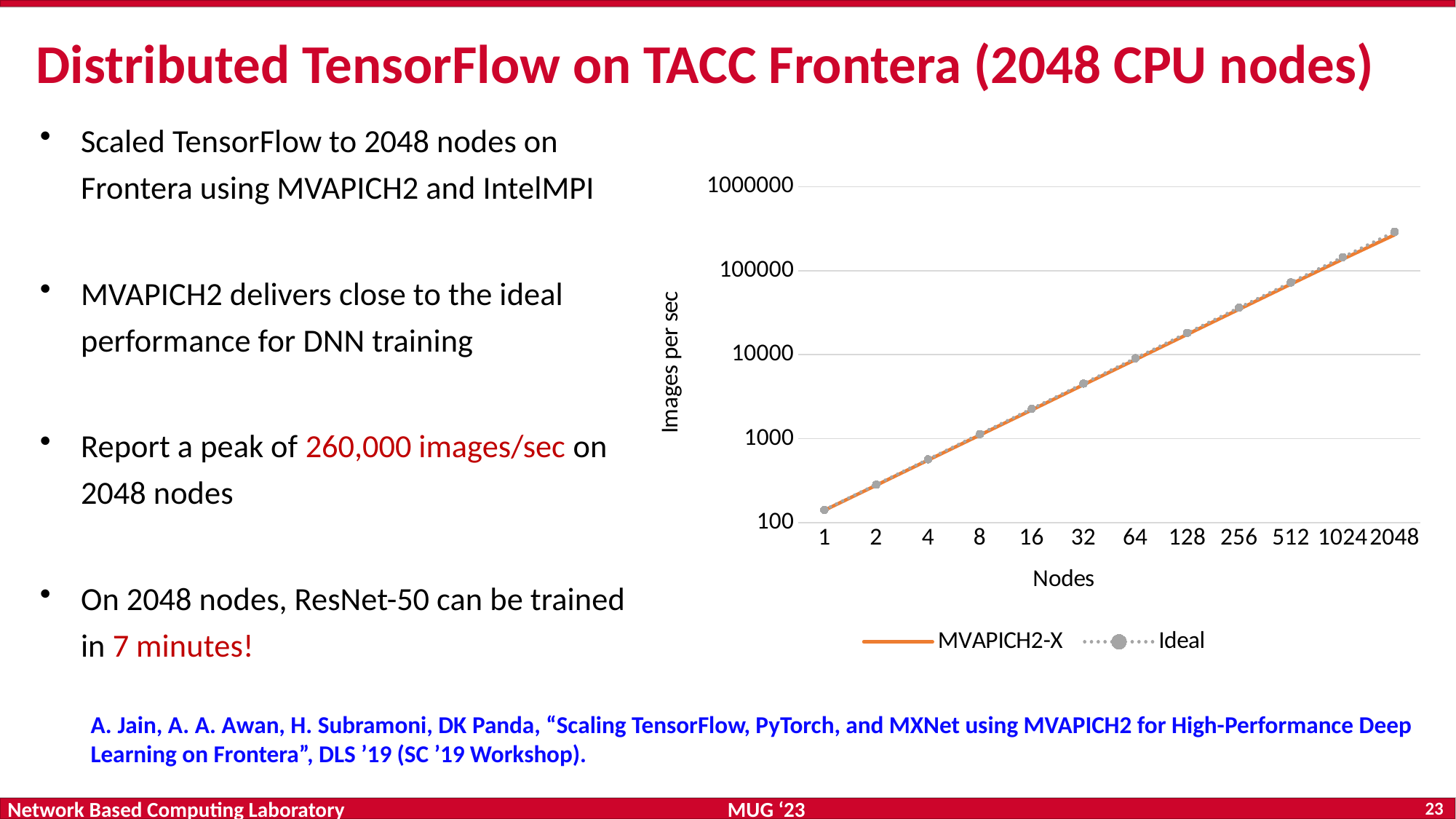
Is the MVAPICH2-X value at 2048 nodes greater or less than 100000 images per sec? greater Is the MVAPICH2-X value at 128 nodes greater or less than 10000 images per sec? greater Is the MVAPICH2-X value at 1 node greater or less than 1000 images per sec? less Do the MVAPICH2-X values rise or fall as the number of nodes increases? rise How many node counts are plotted along the x axis of the chart? 12 What is the label of the y axis of the chart? Images per sec How many series does the chart legend list? 2 Which node count has the highest MVAPICH2-X value in the chart? 2048 What are the two series named in the chart legend? MVAPICH2-X and Ideal What kind of chart is shown on the slide? line chart